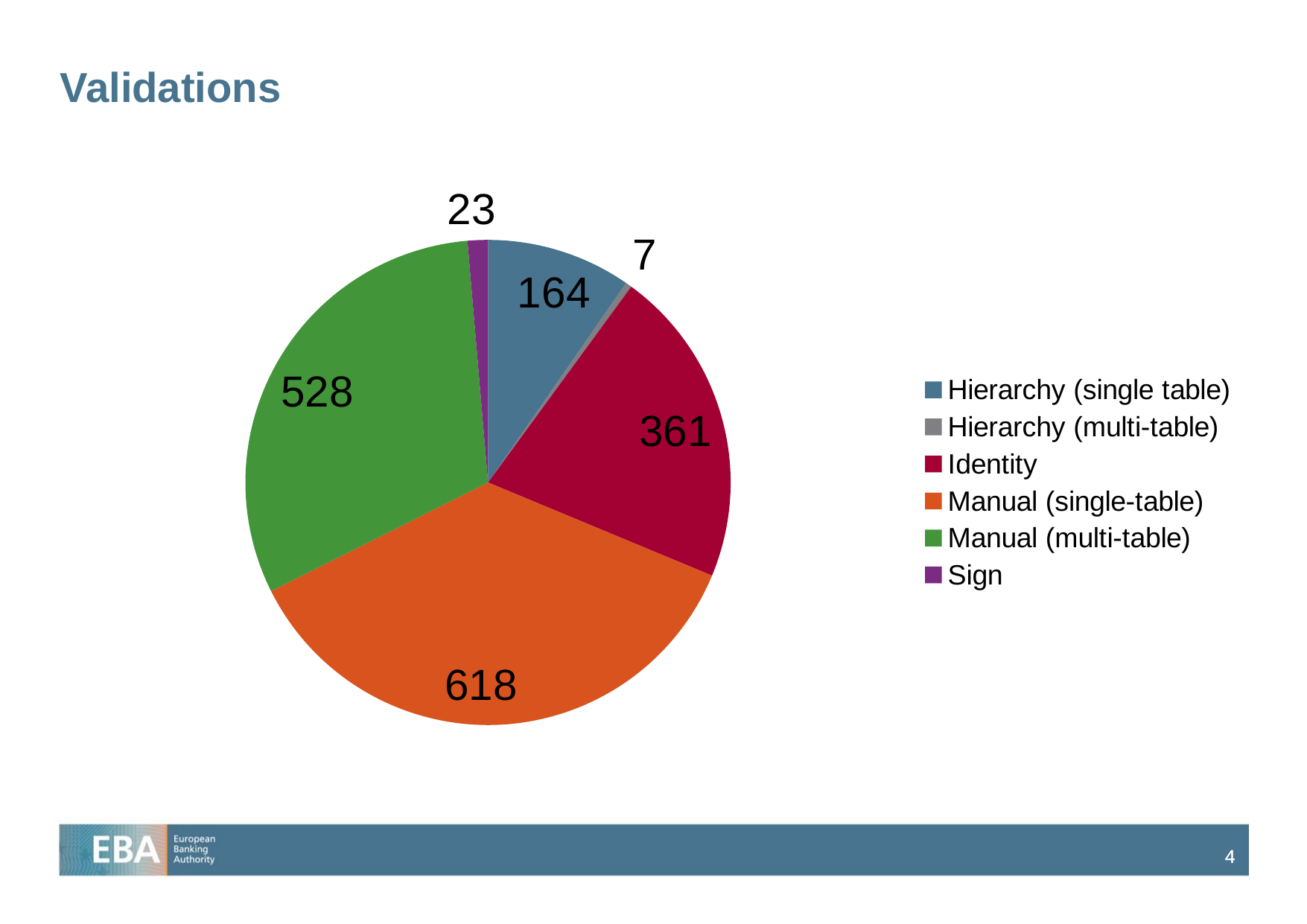
What is the value for Manual (single-table)? 618 What is the value for Sign? 23 What is the difference between Manual (single-table) and Manual (multi-table)? 90 What is the total of all slices in the pie chart? 1701 Which category has the largest slice? Manual (single-table) Which category has the smallest slice? Hierarchy (multi-table) What is the value for Hierarchy (multi-table)? 7 How many categories does the pie chart have? 6 What is the title of the slide containing the chart? Validations What is the value for Identity? 361 What type of chart is shown on the slide? Pie chart Which is larger, Identity or Hierarchy (single table)? Identity